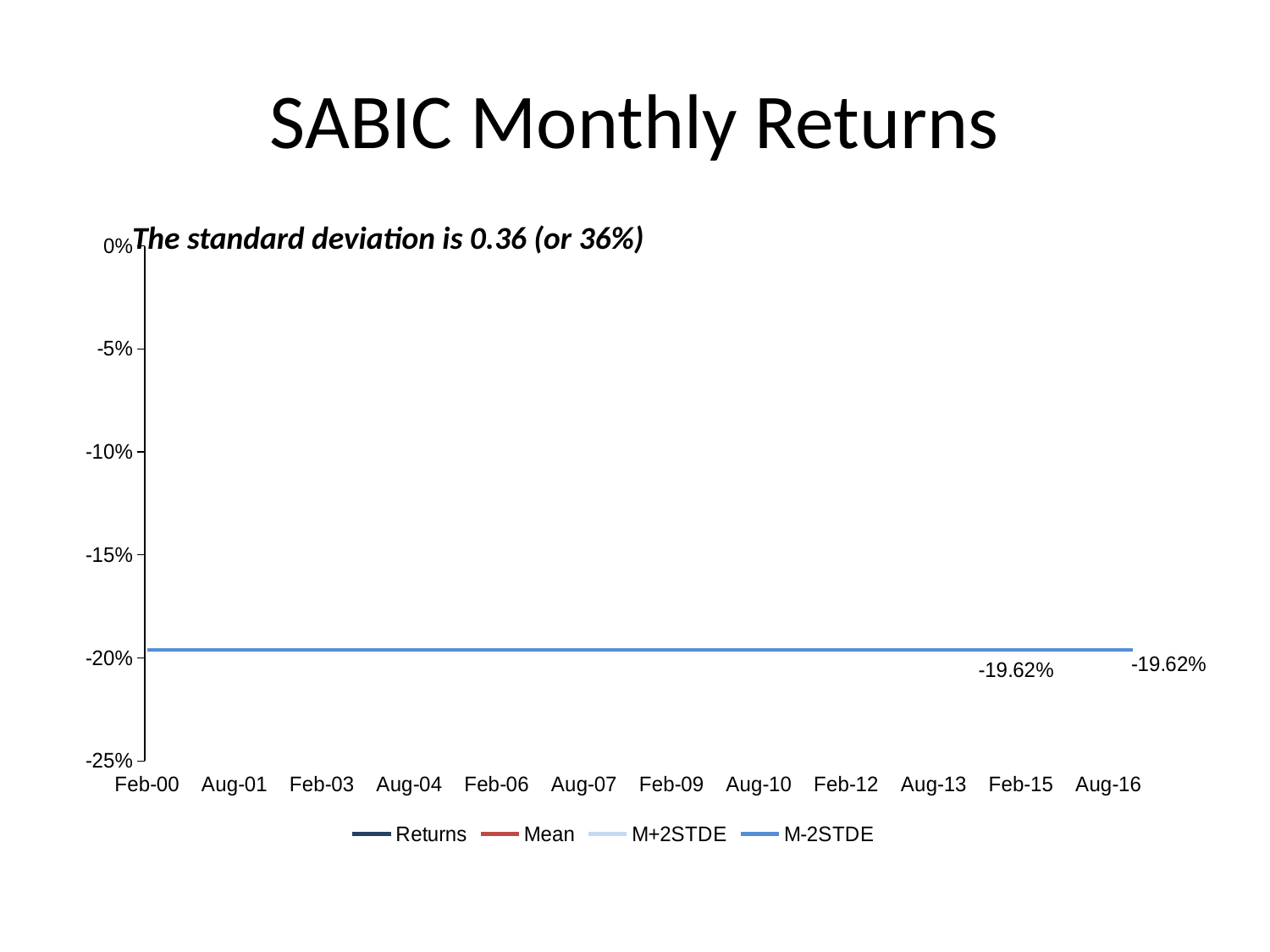
How many series does the legend list? 4 How many date labels are shown on the x axis? 12 What value does the M-2STDE line sit at, according to its data label? -19.62% Is the value of the M-2STDE line greater or less than -20%? greater What is the title of the slide? SABIC Monthly Returns What is the last date label on the x axis? Aug-16 Does the M-2STDE line rise, fall, or stay flat across the x axis? stays flat What standard deviation does the text on the chart state? 0.36 (or 36%) What is the first date label on the x axis? Feb-00 Is the value of the M-2STDE line greater or less than -15%? less What kind of chart is shown on the slide? line chart